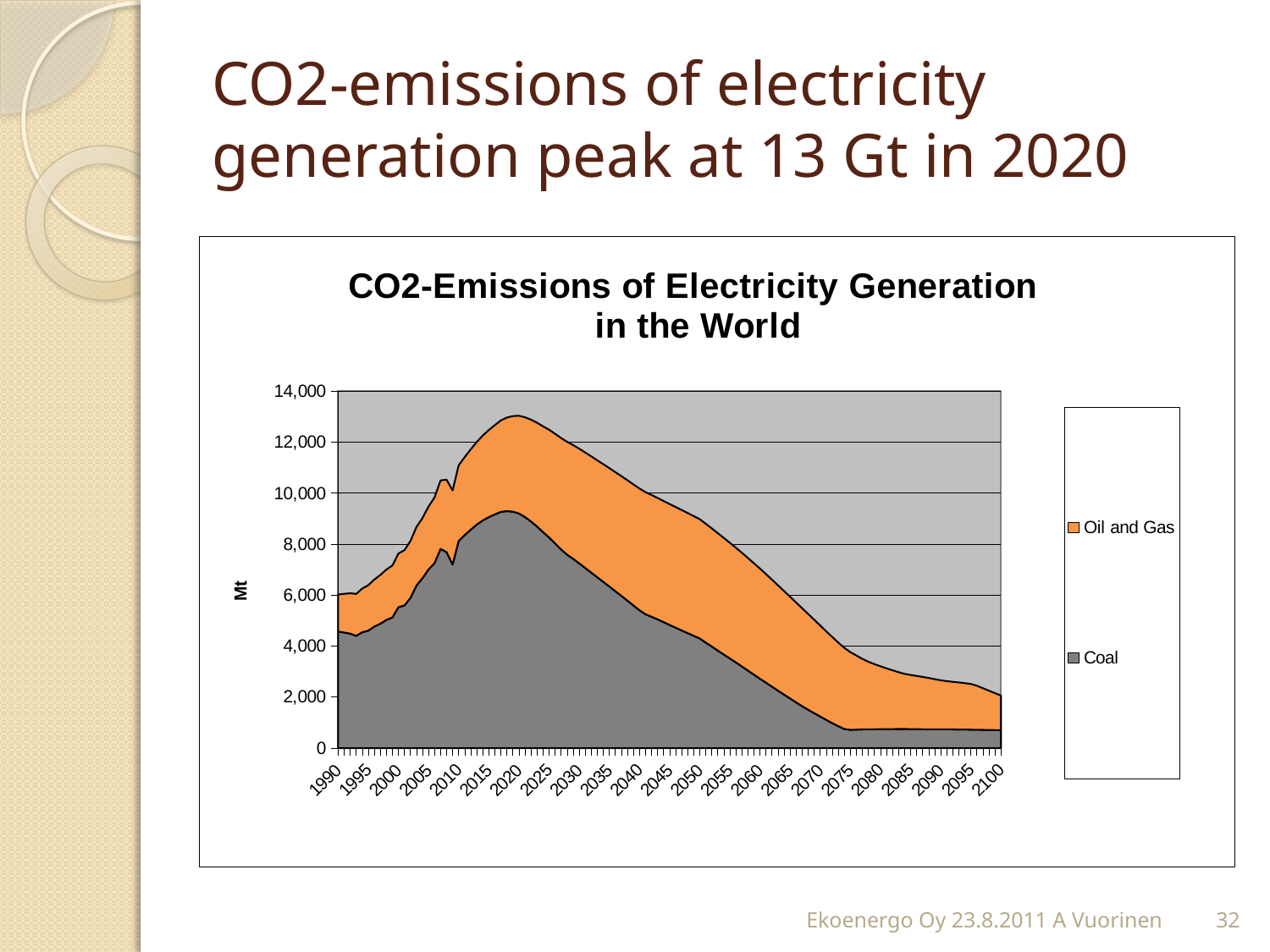
Is the value for Coal in 2020 greater or less than 8,000? greater What are the two series named in the chart legend? Oil and Gas, Coal Is the value for Coal in 2100 greater or less than 2,000? less What is the label on the vertical axis of the chart? Mt Which series is larger in 2100, Coal or Oil and Gas? Oil and Gas Which series is larger in 2020, Coal or Oil and Gas? Coal What kind of chart is shown on the slide? Stacked area chart Do the Coal emissions rise or fall between 2020 and 2100? fall In which year do total CO2 emissions of electricity generation reach their peak in the chart? 2020 Is the total of Coal and Oil and Gas in 2050 greater or less than 10,000? less How many series does the chart legend list? 2